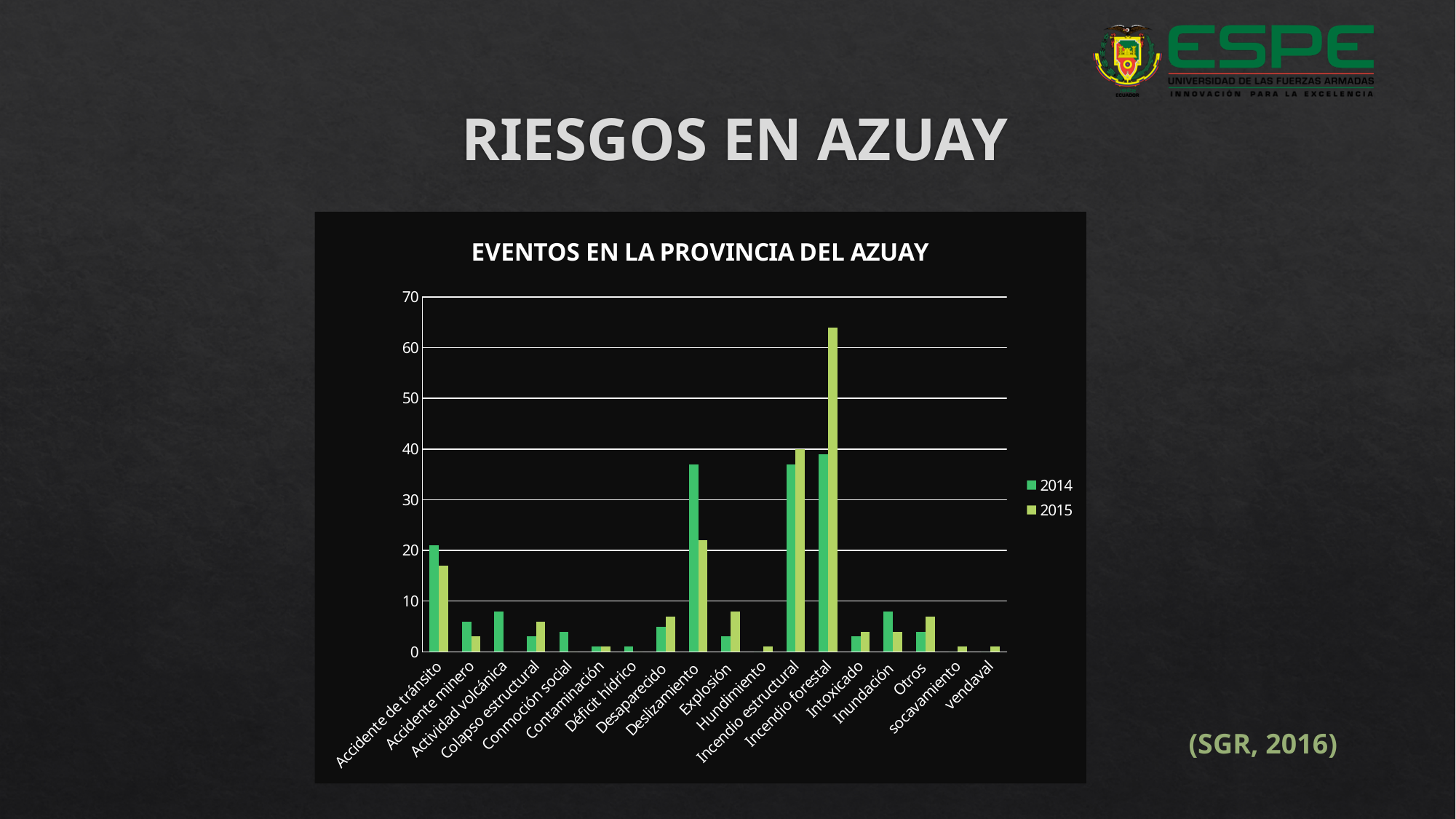
How many event categories are shown on the x axis? 18 Is the 2015 value for Deslizamiento greater or less than 30? less For Incendio forestal, which year has the larger value, 2014 or 2015? 2015 For Deslizamiento, which year has the larger value, 2014 or 2015? 2014 Which years are listed in the legend? 2014 and 2015 Is the 2014 value for Accidente de tránsito greater or less than 10? greater What is the title of the chart? EVENTOS EN LA PROVINCIA DEL AZUAY How many series does the legend list? 2 Is the 2015 value for Incendio forestal greater or less than 60? greater Which category has the highest bar in the chart? Incendio forestal What kind of chart is shown on the slide? Bar chart